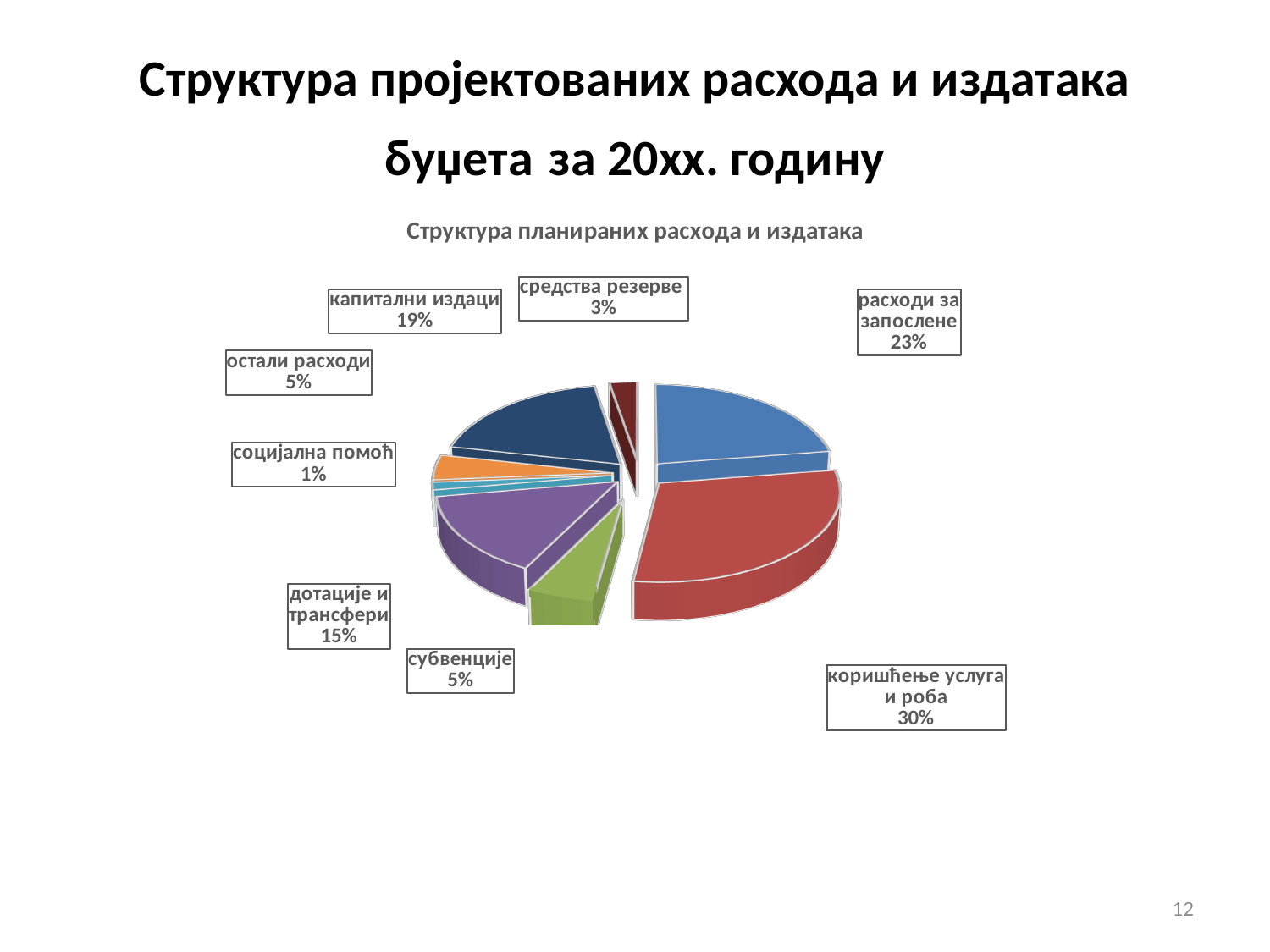
Which is larger, the share for "капитални издаци" or the share for "дотације и трансфери"? капитални издаци What is the title of the chart? Структура планираних расхода и издатака What is the value shown for "капитални издаци"? 19% What is the value shown for "дотације и трансфери"? 15% What share of the pie does "коришћење услуга и роба" have? 30% What is the difference between the shares of "коришћење услуга и роба" and "расходи за запослене"? 7% Which category has the smallest share of the pie? социјална помоћ How many categories are shown in the pie chart? 8 What is the value shown for "средства резерве"? 3% What is the value shown for "расходи за запослене"? 23% Which category has the largest share of the pie? коришћење услуга и роба What kind of chart is shown on the slide? pie chart